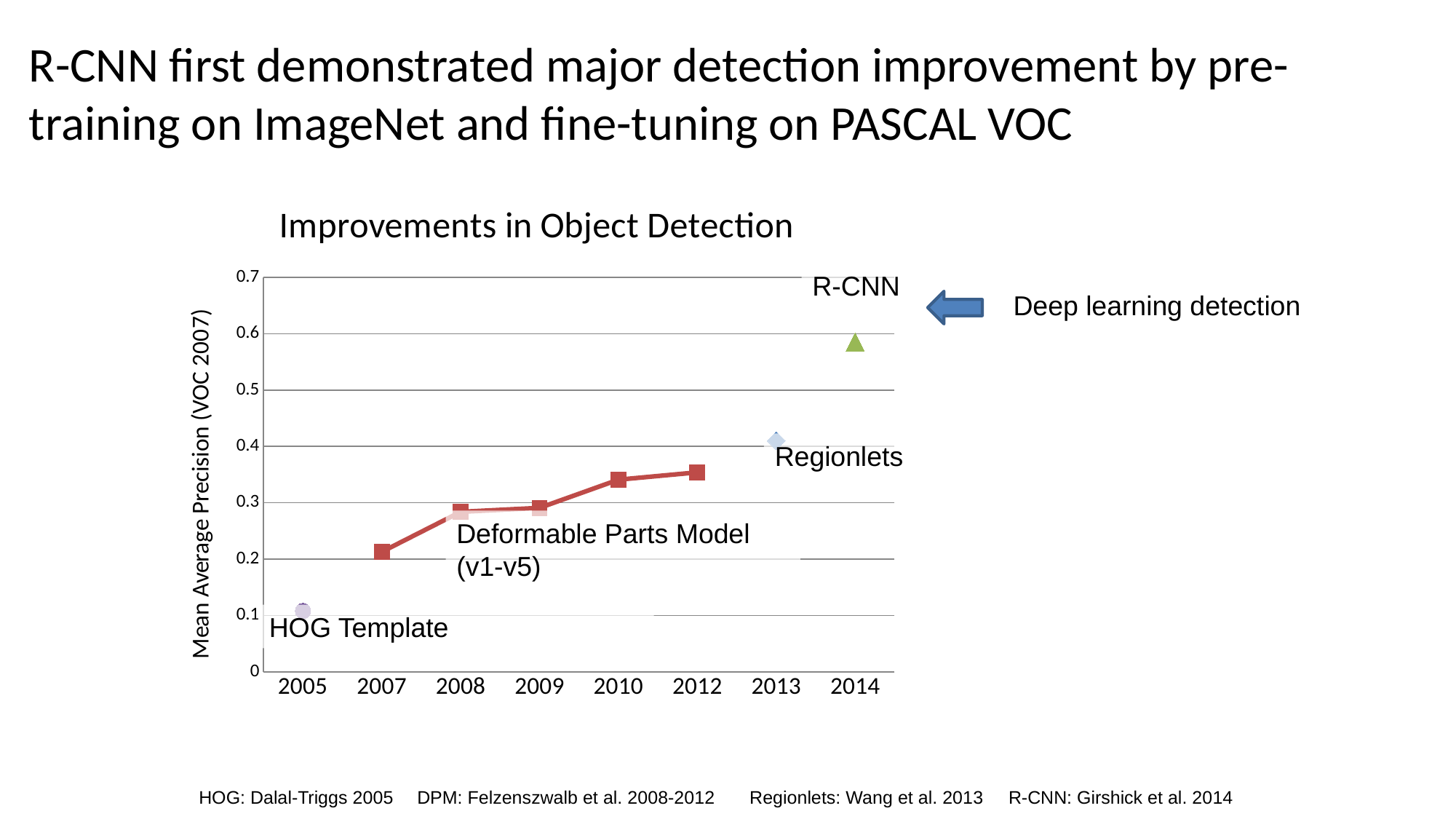
What is the title of the chart on the slide? Improvements in Object Detection Is the value for R-CNN (2014) greater or less than 0.5? greater What is the label of the y axis of the chart? Mean Average Precision (VOC 2007) Is the value for Regionlets (2013) greater or less than 0.3? greater Is the value for 2012 greater or less than 0.3? greater How many years are shown on the x axis of the chart? 8 Which labelled method has the lowest mean average precision? HOG Template Which labelled method has the highest mean average precision? R-CNN Which year on the x axis has the highest mean average precision? 2014 Which has the larger mean average precision, 2007 or 2010? 2010 Do the values generally rise or fall from 2005 to 2014? rise